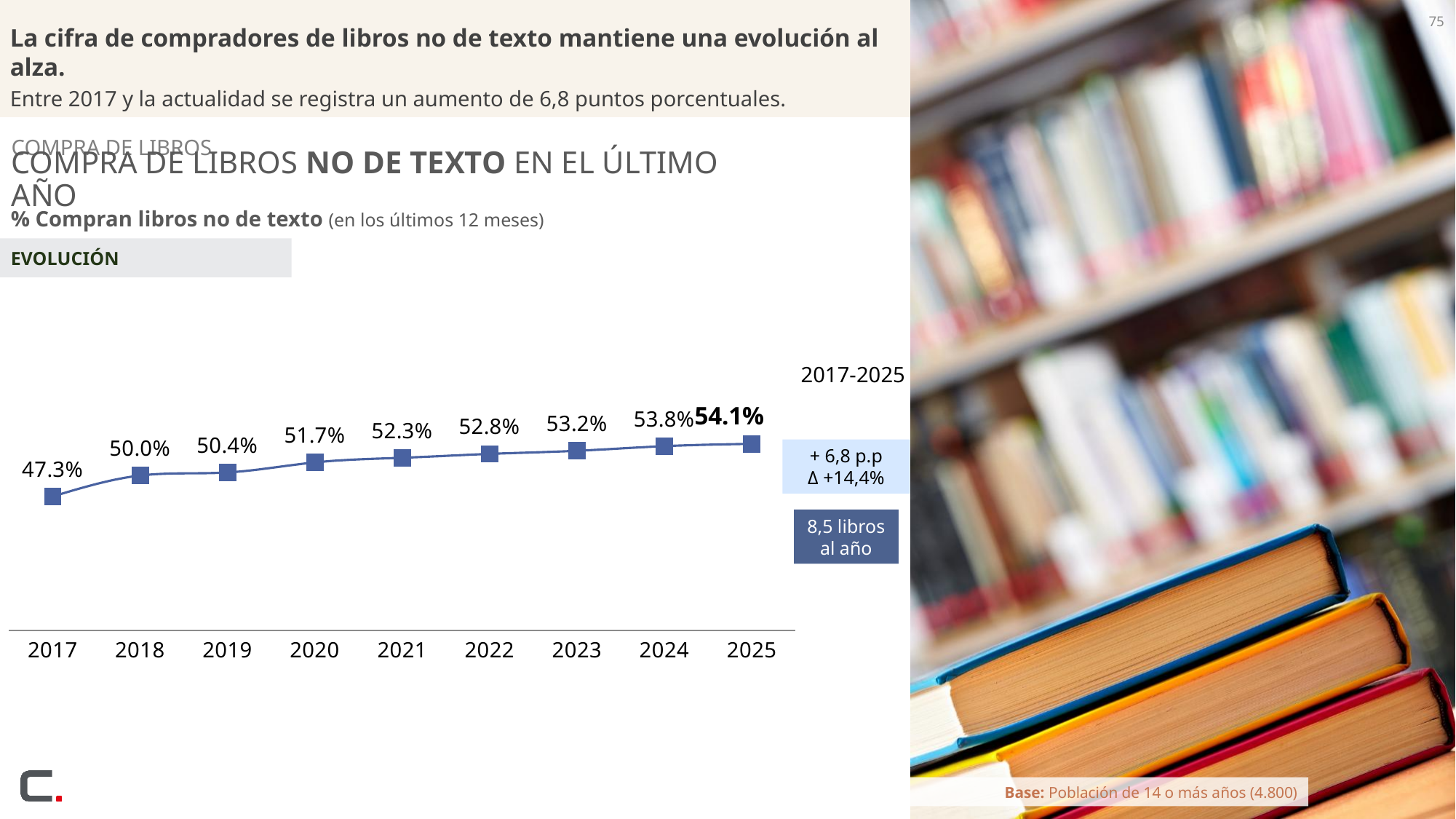
What is the value for 2021? 52.3% What is the difference between the values for 2020 and 2019? 1.3 percentage points What is the subtitle printed above the chart describing what is plotted? % Compran libros no de texto (en los últimos 12 meses) Which year has the lowest value? 2017 What is the value for 2025? 54.1% What is the difference between the values for 2025 and 2017? 6.8 percentage points Do the values rise or fall from 2017 to 2025? Rise What is the value for 2017? 47.3% Which year has the highest value? 2025 What kind of chart is shown? Line chart How many years are plotted on the chart? 9 Which is larger, the value for 2018 or the value for 2022? 2022